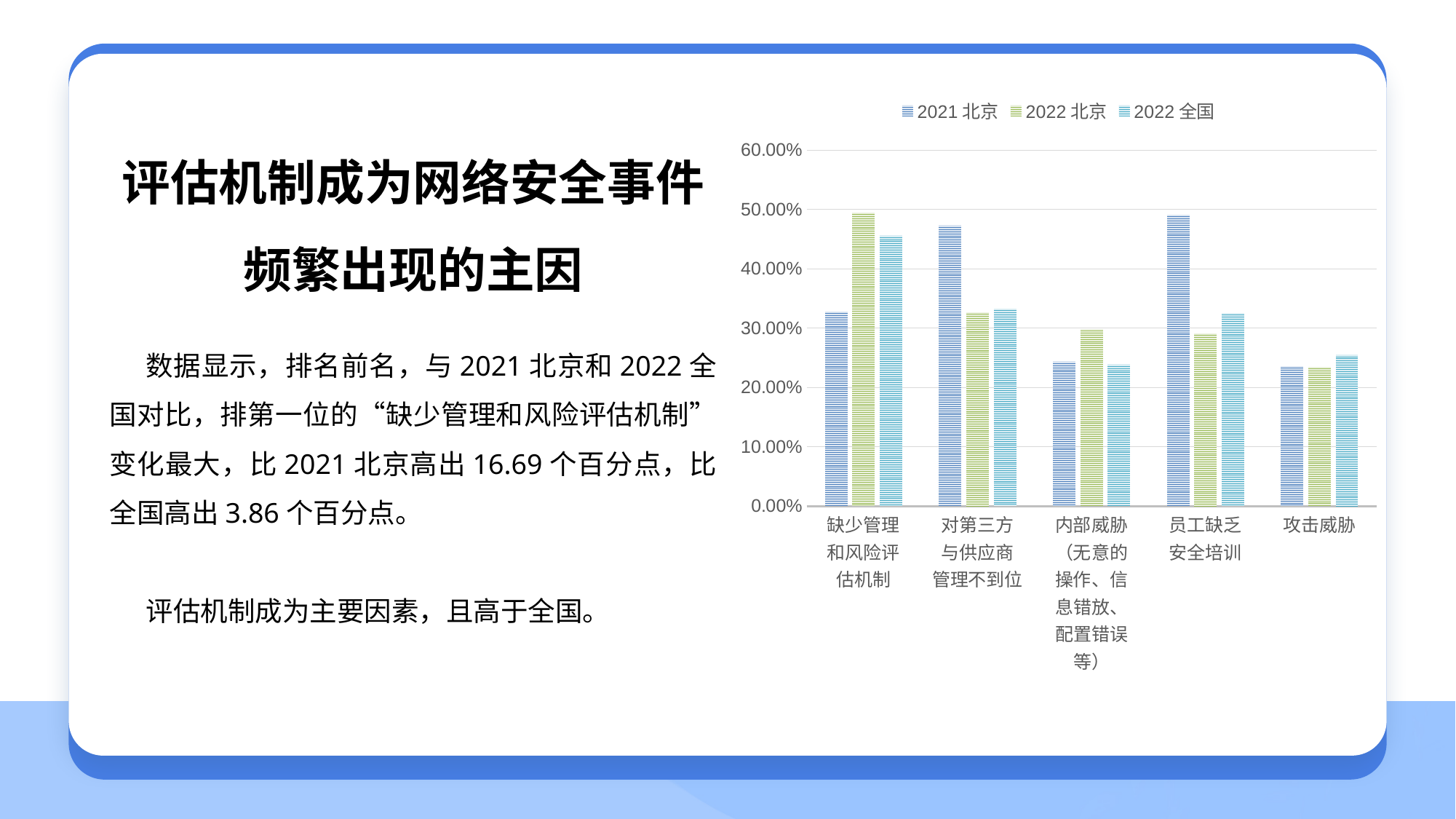
Is the 2021 北京 value for 缺少管理和风险评估机制 greater or less than 40.00%? less Which category has the lowest value for the 2022 北京 series? 攻击威胁 Is the 2022 全国 value for 攻击威胁 greater or less than 30.00%? less Which category has the highest value for the 2022 北京 series? 缺少管理和风险评估机制 How many series does the chart legend list? 3 What kind of chart is shown on the slide? bar chart For 缺少管理和风险评估机制, which is larger: the 2021 北京 value or the 2022 北京 value? 2022 北京 What is the highest tick value shown on the chart's y axis? 60.00% For 员工缺乏安全培训, which is larger: the 2021 北京 value or the 2022 全国 value? 2021 北京 How many categories are shown on the x axis of the chart? 5 Which category has the highest value for the 2022 全国 series? 缺少管理和风险评估机制 Is the 2022 北京 value for 缺少管理和风险评估机制 greater or less than 40.00%? greater